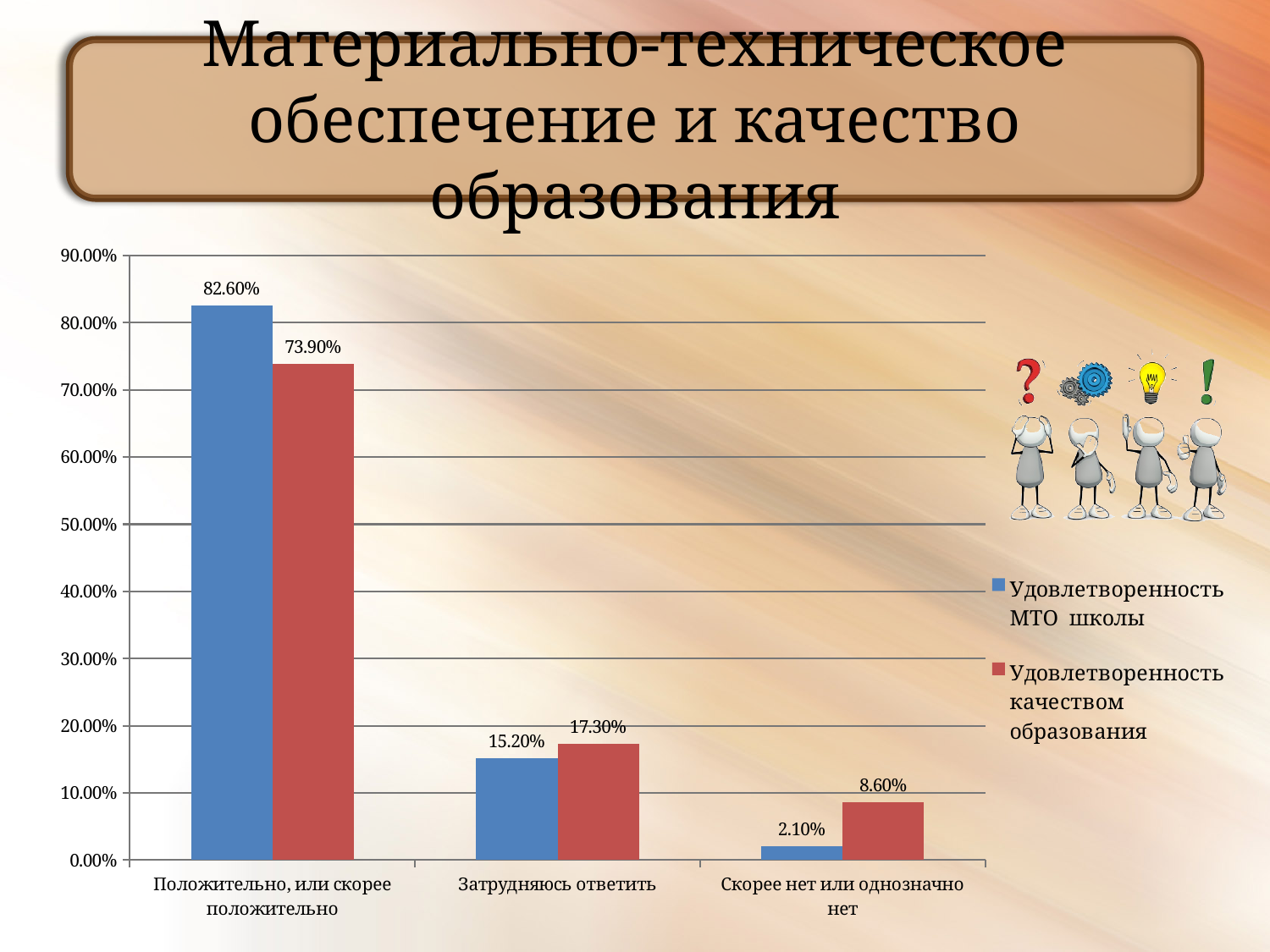
In the category 'Скорее нет или однозначно нет', which series has the larger value? Удовлетворенность качеством образования How many categories are shown on the x axis? 3 How many series does the legend list? 2 What is the value for 'Удовлетворенность МТО школы' in the category 'Скорее нет или однозначно нет'? 2.10% What is the value for 'Удовлетворенность МТО школы' in the category 'Положительно, или скорее положительно'? 82.60% What is the difference between 'Удовлетворенность МТО школы' and 'Удовлетворенность качеством образования' in the category 'Положительно, или скорее положительно'? 8.70% Which category has the lowest value for 'Удовлетворенность МТО школы'? Скорее нет или однозначно нет What is the value for 'Удовлетворенность качеством образования' in the category 'Затрудняюсь ответить'? 17.30% What kind of chart is shown on the slide? bar chart Is the value for 'Удовлетворенность качеством образования' in 'Положительно, или скорее положительно' greater or less than 70.00%? greater Which category has the highest value for 'Удовлетворенность качеством образования'? Положительно, или скорее положительно What colour are the bars for 'Удовлетворенность качеством образования'? red